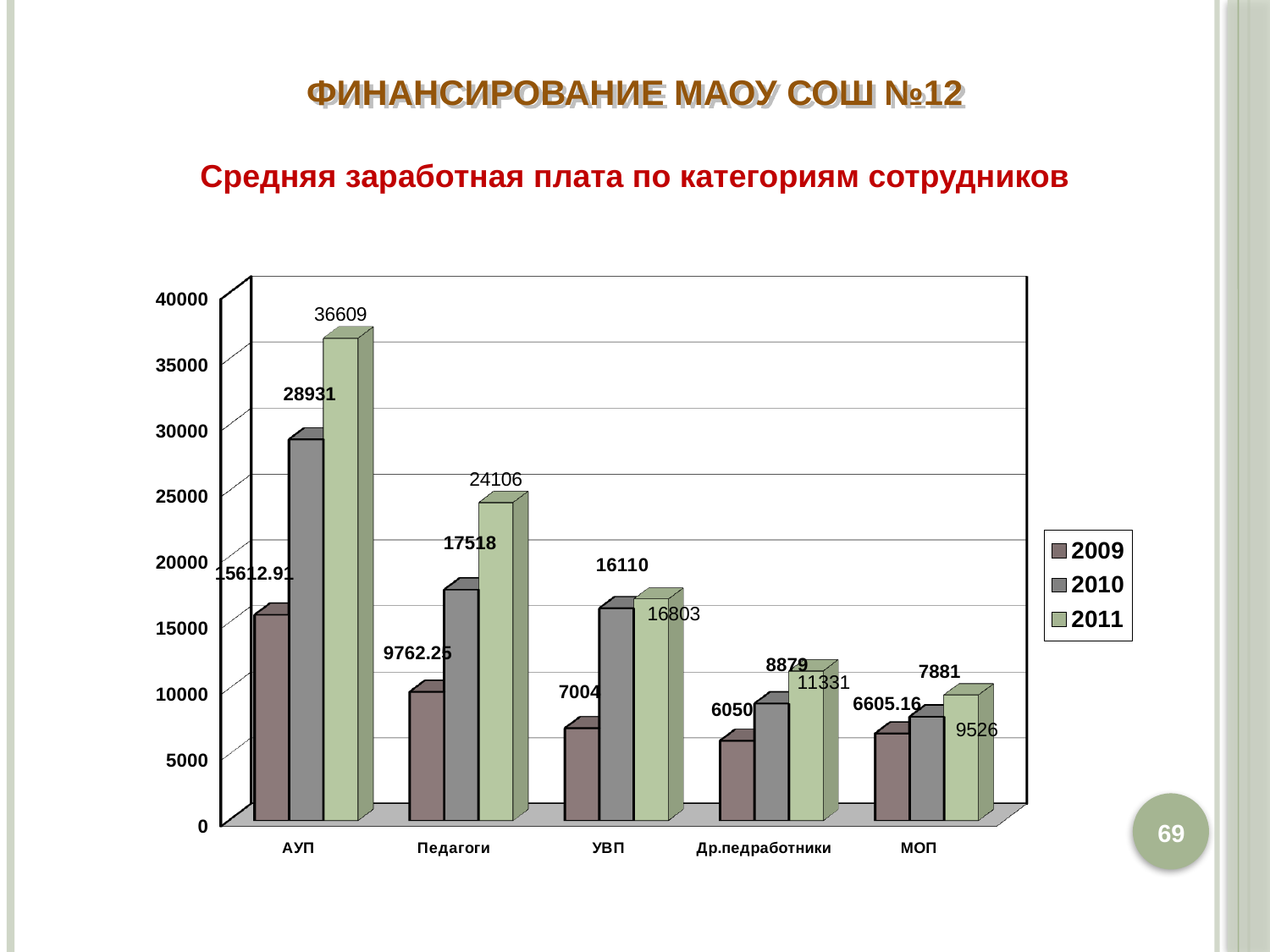
What is the value for АУП in the 2011 series? 36609 What is the subtitle of the chart shown in red on the slide? Средняя заработная плата по категориям сотрудников How many series does the legend list? 3 What kind of chart is shown on the slide? bar chart Which is larger: the 2011 value for Др.педработники or the 2011 value for МОП? Др.педработники What is the value for УВП in the 2010 series? 16110 What is the value for МОП in the 2011 series? 9526 What is the value for Педагоги in the 2009 series? 9762.25 What is the difference between the 2011 and 2010 values for Педагоги? 6588 How many categories are shown on the x axis? 5 Which category has the highest value in the 2010 series? АУП Which category has the lowest value in the 2009 series? Др.педработники